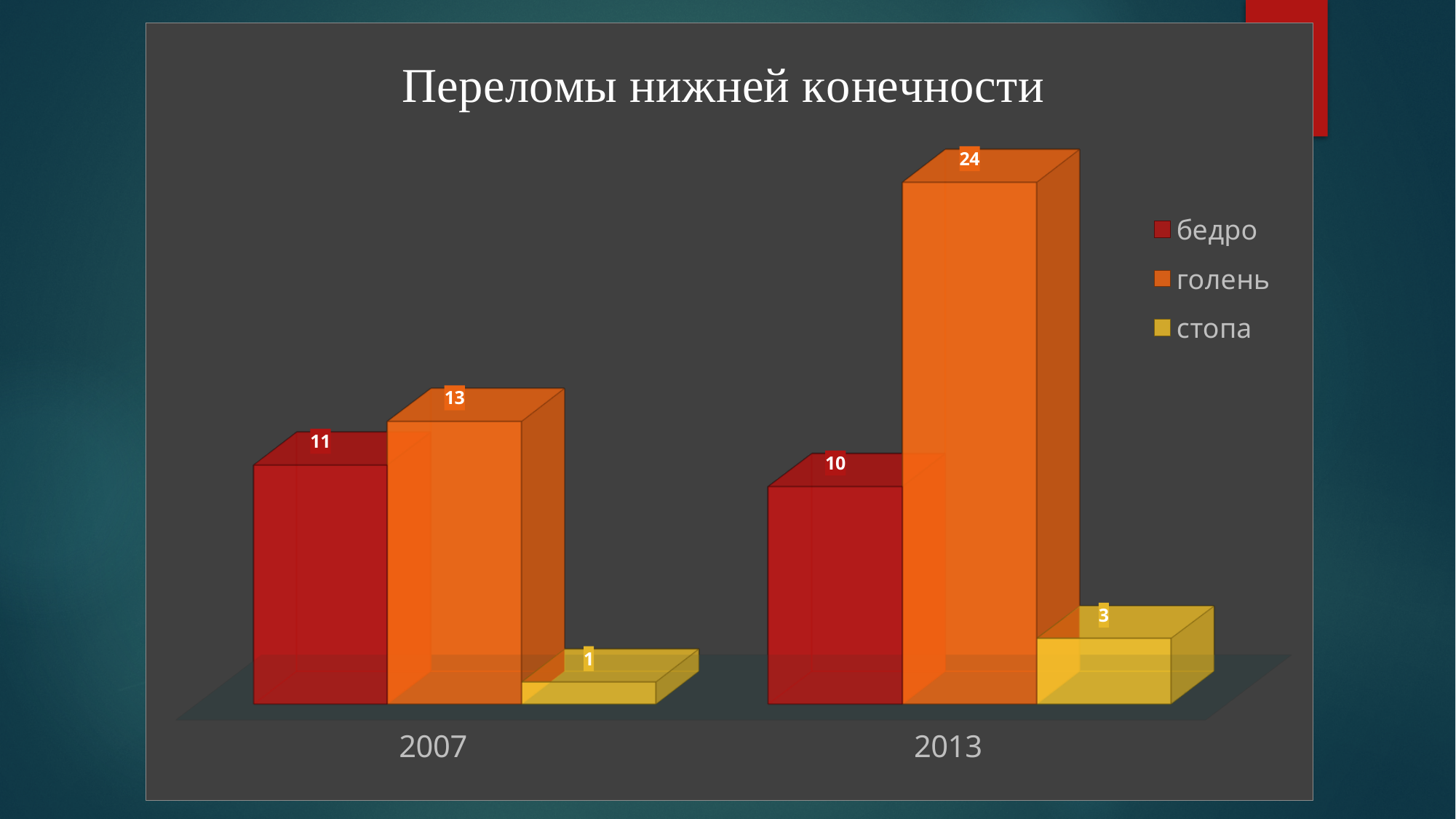
What is the title of the chart? Переломы нижней конечности Which series has the highest value in 2013? голень What is the value for бедро in 2007? 11 How many series does the legend list? 3 What kind of chart is shown on the slide? bar chart What is the value for стопа in 2013? 3 How many categories are shown on the x axis? 2 What is the value for голень in 2007? 13 Which series has the lowest value in 2007? стопа What is the difference between the голень values for 2013 and 2007? 11 What is the value for голень in 2013? 24 Which is larger, the бедро value in 2007 or in 2013? 2007